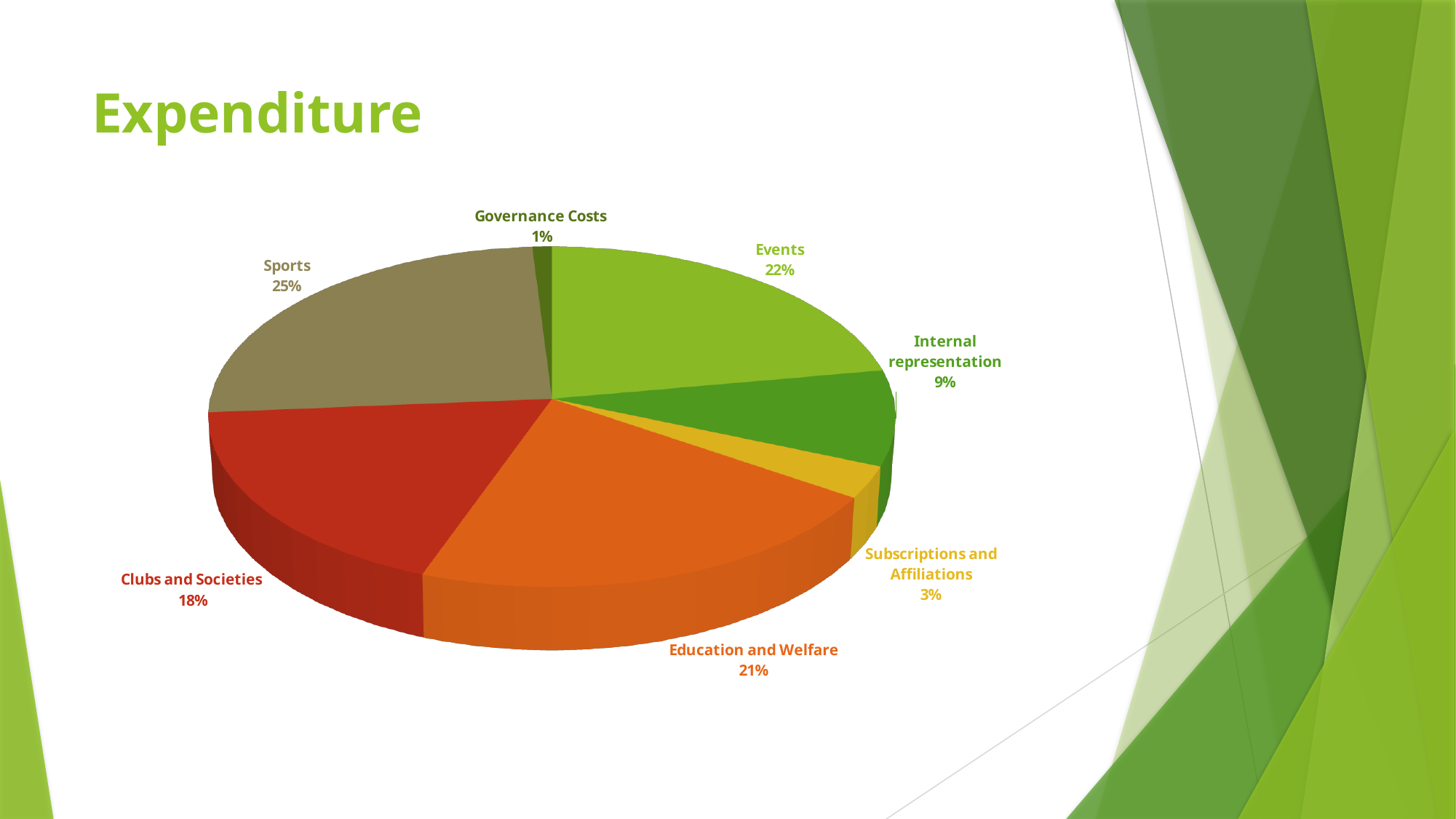
What share does Education and Welfare have in the pie chart? 21% What percentage of expenditure is Events? 22% What is the difference in percentage points between Sports and Clubs and Societies? 7 Which category has the largest share of expenditure? Sports Which is larger, Events or Education and Welfare? Events How many categories are shown in the pie chart? 7 What share of expenditure is Internal representation? 9% What percentage is shown for Clubs and Societies? 18% What share of expenditure goes to Sports? 25% Which category has the smallest share of expenditure? Governance Costs What type of chart is shown on the slide? Pie chart What percentage is Subscriptions and Affiliations? 3%